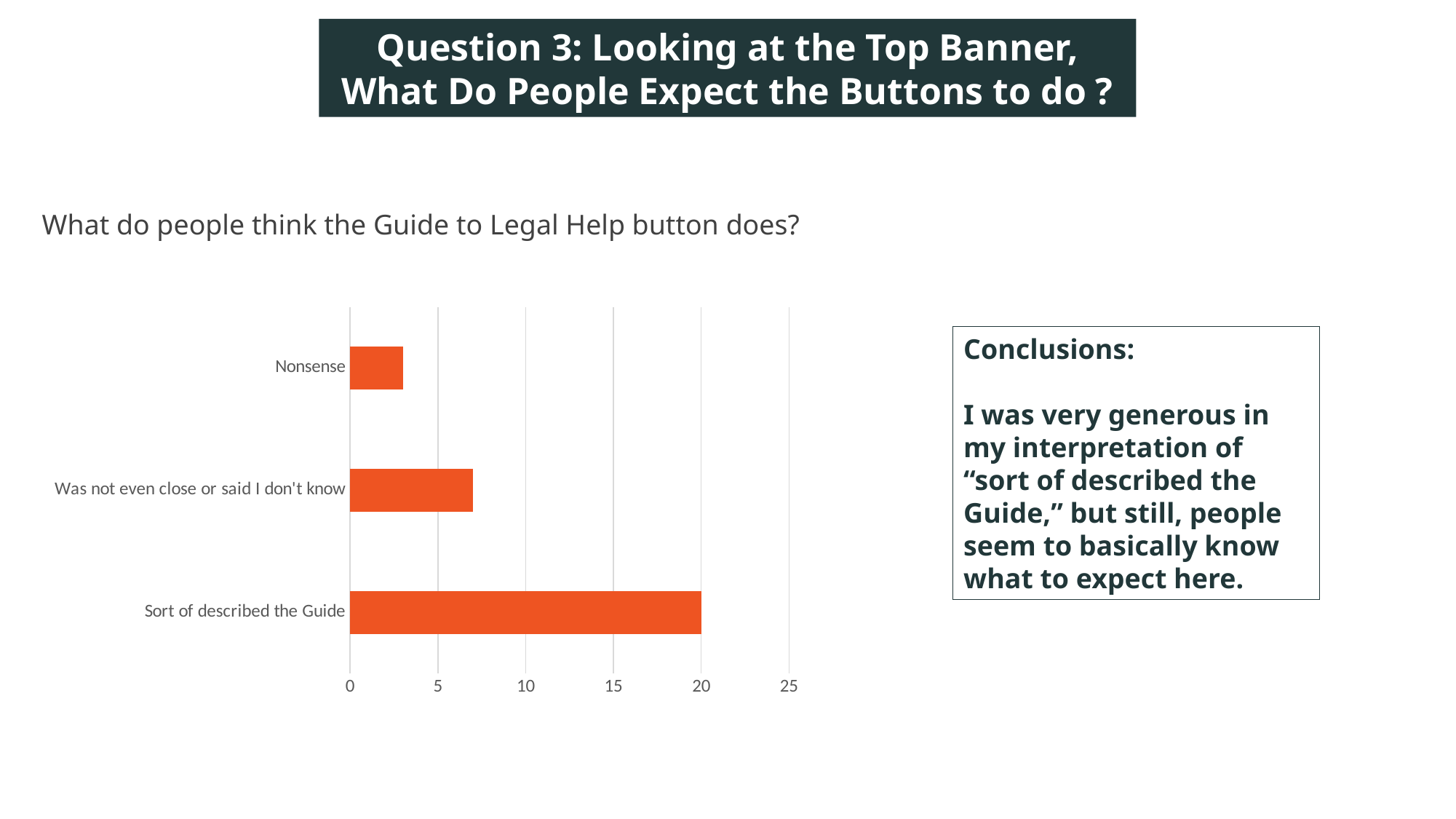
Is the value for "Sort of described the Guide" greater or less than 15? greater Which category has the highest value? Sort of described the Guide Is the value for "Was not even close or said I don't know" greater or less than 5? greater How many categories does the chart show? 3 Which is larger, the value for "Nonsense" or the value for "Was not even close or said I don't know"? Was not even close or said I don't know What is the highest value shown on the x axis? 25 What kind of chart is shown on the slide? bar chart Is the value for "Was not even close or said I don't know" greater or less than 10? less What is the value for "Sort of described the Guide"? 20 Which category has the lowest value? Nonsense What is the title of the chart? What do people think the Guide to Legal Help button does?